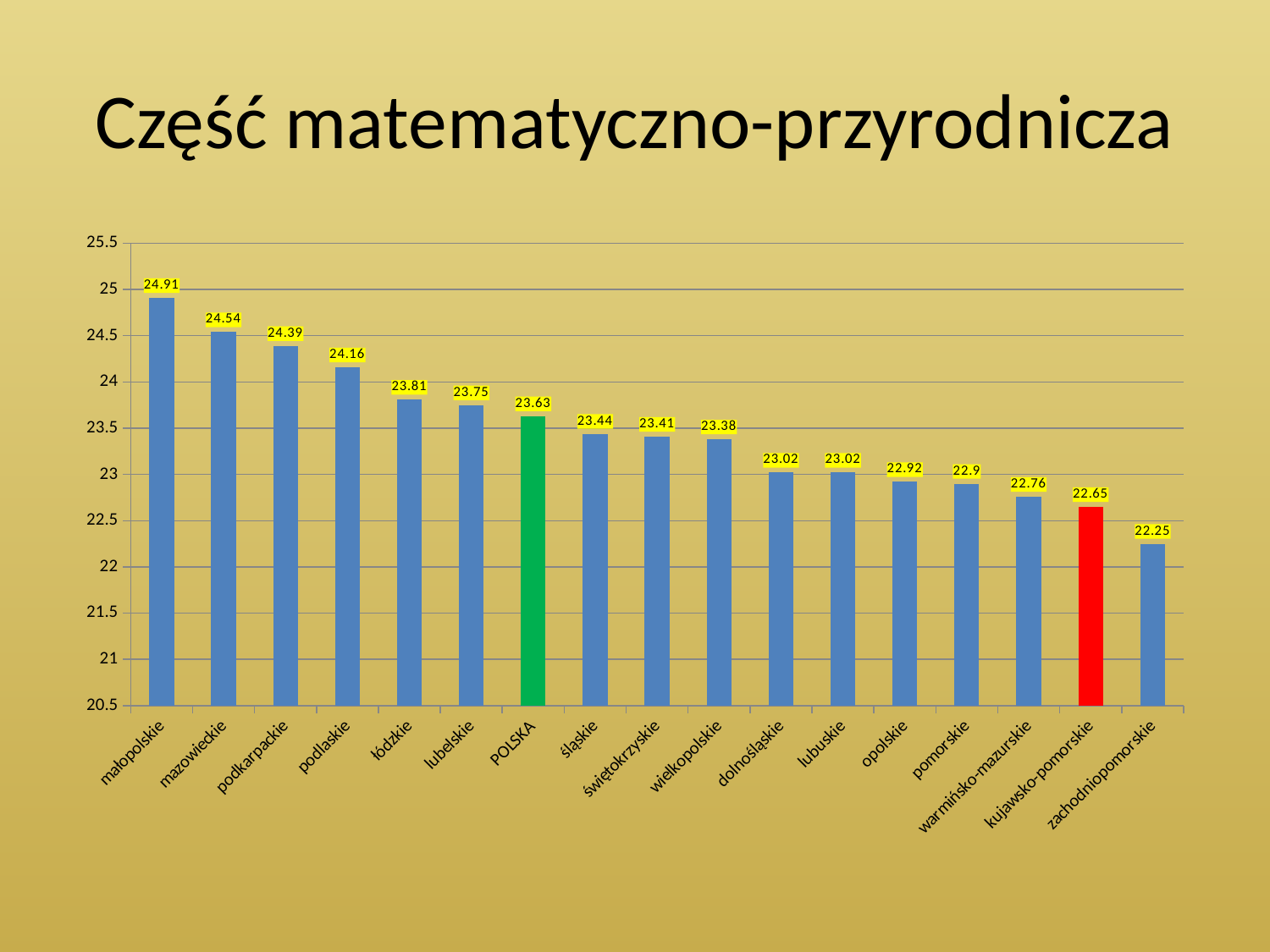
Which category has the lowest value? zachodniopomorskie What is the difference between the values for małopolskie and zachodniopomorskie? 2.66 What is the value for POLSKA? 23.63 Which is larger, the value for podlaskie or the value for łódzkie? podlaskie What is the value for małopolskie? 24.91 What is the value for warmińsko-mazurskie? 22.76 What kind of chart is shown on the slide? bar chart How many categories are shown on the x axis? 17 Do the values rise or fall from left to right along the x axis? fall What is the value for kujawsko-pomorskie? 22.65 What is the difference between the values for POLSKA and kujawsko-pomorskie? 0.98 Which category has the highest value? małopolskie